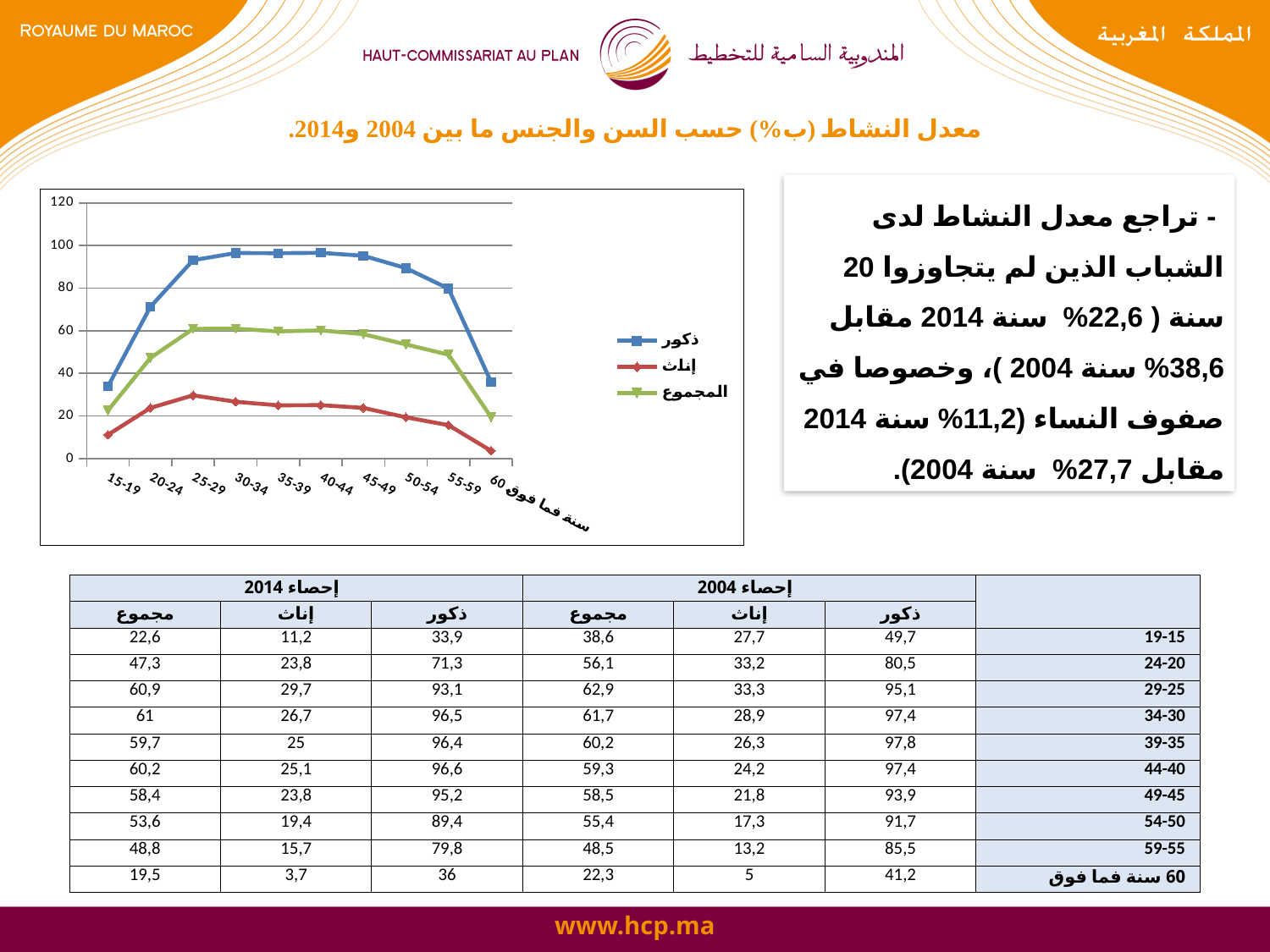
Does the ذكور series rise or fall from 15-19 to 25-29? rise Is the value of the إناث series for 25-29 greater or less than 40? less Is the value of the المجموع series for 25-29 greater or less than 40? greater Which series in the chart has the highest values across all age groups? ذكور What kind of chart is shown on the slide? line chart How many age-group categories are plotted along the x axis of the chart? 10 For the إناث series, which age group has the lowest value? 60 سنة فما فوق What colour is the line for the ذكور series in the chart? blue Is the value of the ذكور series for 30-34 greater or less than 80? greater How many series does the chart's legend list? 3 At 30-34, which series has the larger value, ذكور or إناث? ذكور